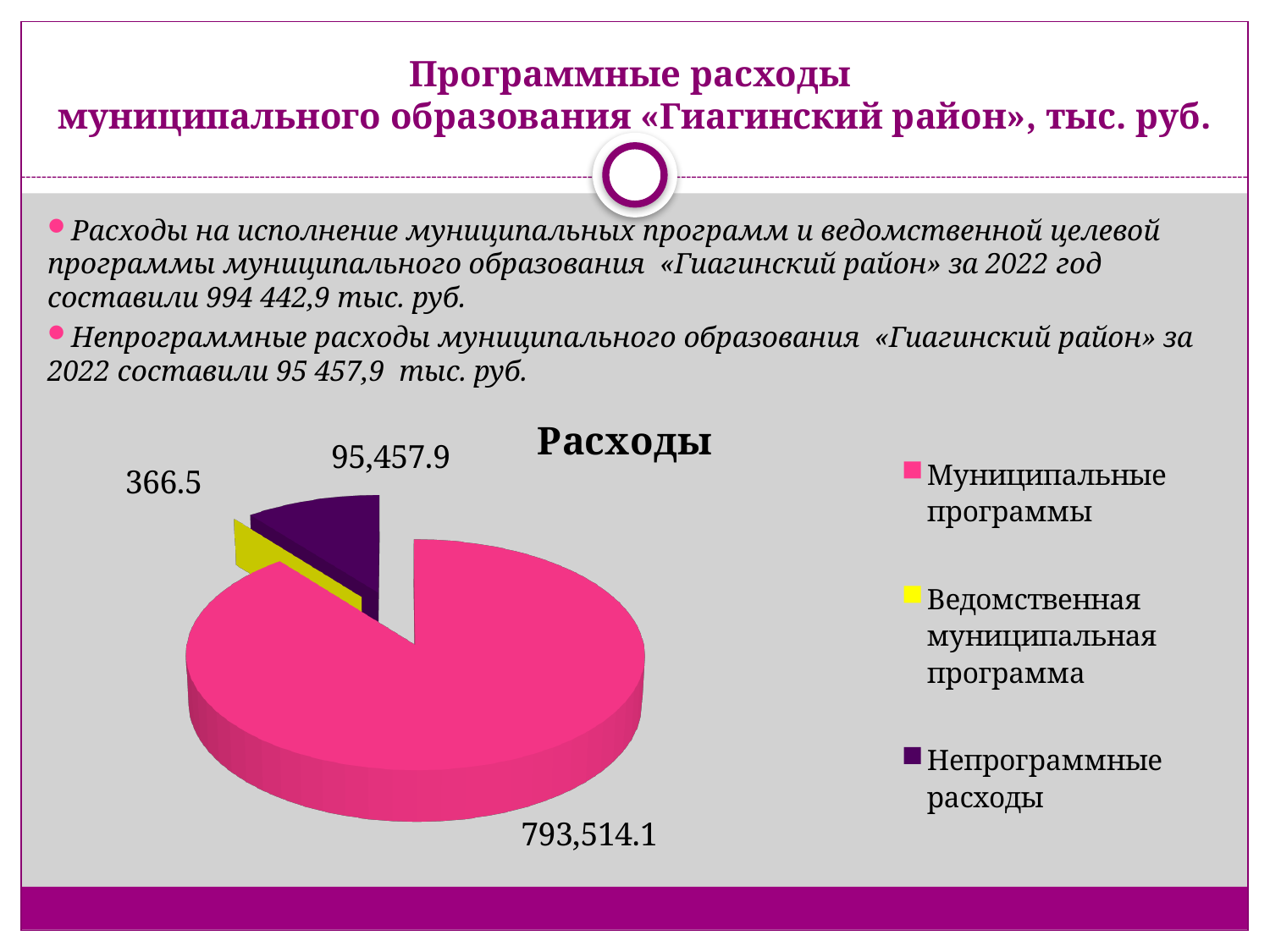
Which colour represents Непрограммные расходы in the chart? Dark purple What type of chart is shown on the slide? Pie chart What is the difference between the values for Муниципальные программы and Непрограммные расходы? 698,056.2 Which category has the smallest slice of the pie? Ведомственная муниципальная программа Which category has the largest slice of the pie? Муниципальные программы What is the title of the chart? Расходы How many slices does the pie chart have? 3 What is the value for Непрограммные расходы? 95,457.9 What is the value for Муниципальные программы? 793,514.1 What is the value for Ведомственная муниципальная программа? 366.5 How many entries does the chart legend list? 3 Which is larger: Непрограммные расходы or Ведомственная муниципальная программа? Непрограммные расходы